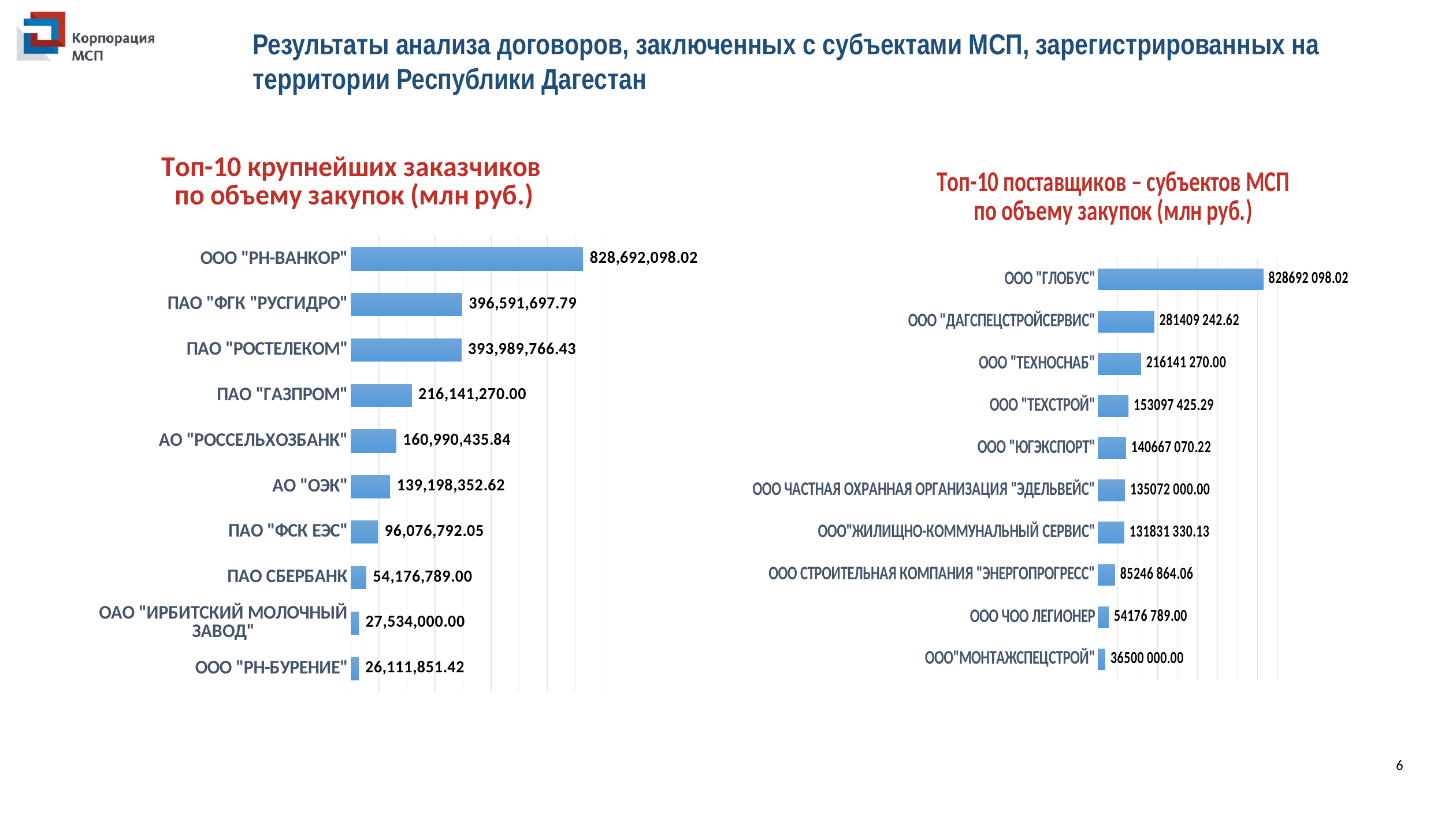
In the right chart (Топ-10 поставщиков – субъектов МСП), which supplier has the highest purchase volume? ООО "ГЛОБУС" What type of chart is the right chart (Топ-10 поставщиков – субъектов МСП)? Bar chart In the left chart (Топ-10 крупнейших заказчиков), what is the value for ПАО "ГАЗПРОМ"? 216,141,270.00 In the right chart (Топ-10 поставщиков – субъектов МСП), which is larger: the value for ООО "ДАГСПЕЦСТРОЙСЕРВИС" or the value for ООО "ТЕХНОСНАБ"? ООО "ДАГСПЕЦСТРОЙСЕРВИС" In the left chart (Топ-10 крупнейших заказчиков), how many customers are shown? 10 In the left chart (Топ-10 крупнейших заказчиков), what is the difference between the values for ПАО "ФГК "РУСГИДРО" and ПАО "РОСТЕЛЕКОМ"? 2,601,931.36 In the right chart (Топ-10 поставщиков – субъектов МСП), which supplier has the lowest purchase volume? ООО"МОНТАЖСПЕЦСТРОЙ" In the right chart (Топ-10 поставщиков – субъектов МСП), what is the value for ООО "ТЕХСТРОЙ"? 153097 425.29 In the left chart (Топ-10 крупнейших заказчиков), which customer has the lowest purchase volume? ООО "РН-БУРЕНИЕ" In the right chart (Топ-10 поставщиков – субъектов МСП), what is the value for ООО ЧОО ЛЕГИОНЕР? 54176 789.00 In the left chart (Топ-10 крупнейших заказчиков), what is the value for ПАО СБЕРБАНК? 54,176,789.00 In the left chart (Топ-10 крупнейших заказчиков), which customer has the highest purchase volume? ООО "РН-ВАНКОР"